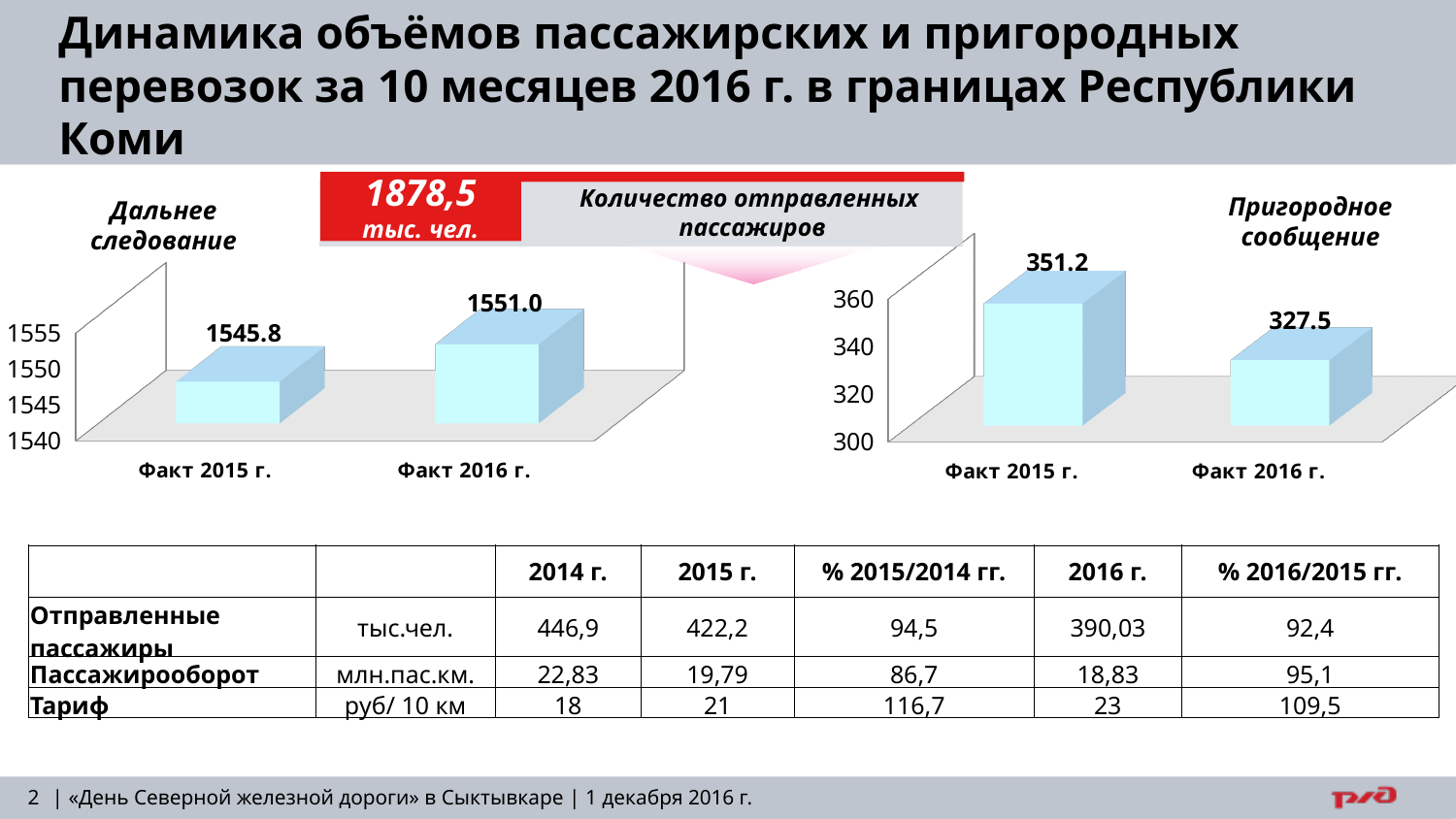
In the 'Пригородное сообщение' chart, which category has the lowest value? Факт 2016 г. In the 'Пригородное сообщение' chart, what is the difference between the Факт 2015 г. and Факт 2016 г. values? 23.7 In the 'Пригородное сообщение' chart, what is the value for Факт 2016 г.? 327.5 In the 'Дальнее следование' chart, what is the value for Факт 2015 г.? 1545.8 What kind of chart is the 'Пригородное сообщение' chart? bar chart In the 'Пригородное сообщение' chart, is the value for Факт 2016 г. greater or less than 320? greater In the 'Дальнее следование' chart, do the values rise or fall from Факт 2015 г. to Факт 2016 г.? rise In the 'Пригородное сообщение' chart, do the values rise or fall from Факт 2015 г. to Факт 2016 г.? fall In the 'Пригородное сообщение' chart, what is the value for Факт 2015 г.? 351.2 In the 'Дальнее следование' chart, which category has the highest value? Факт 2016 г. In the 'Дальнее следование' chart, what is the difference between the Факт 2016 г. and Факт 2015 г. values? 5.2 In the 'Дальнее следование' chart, what is the value for Факт 2016 г.? 1551.0